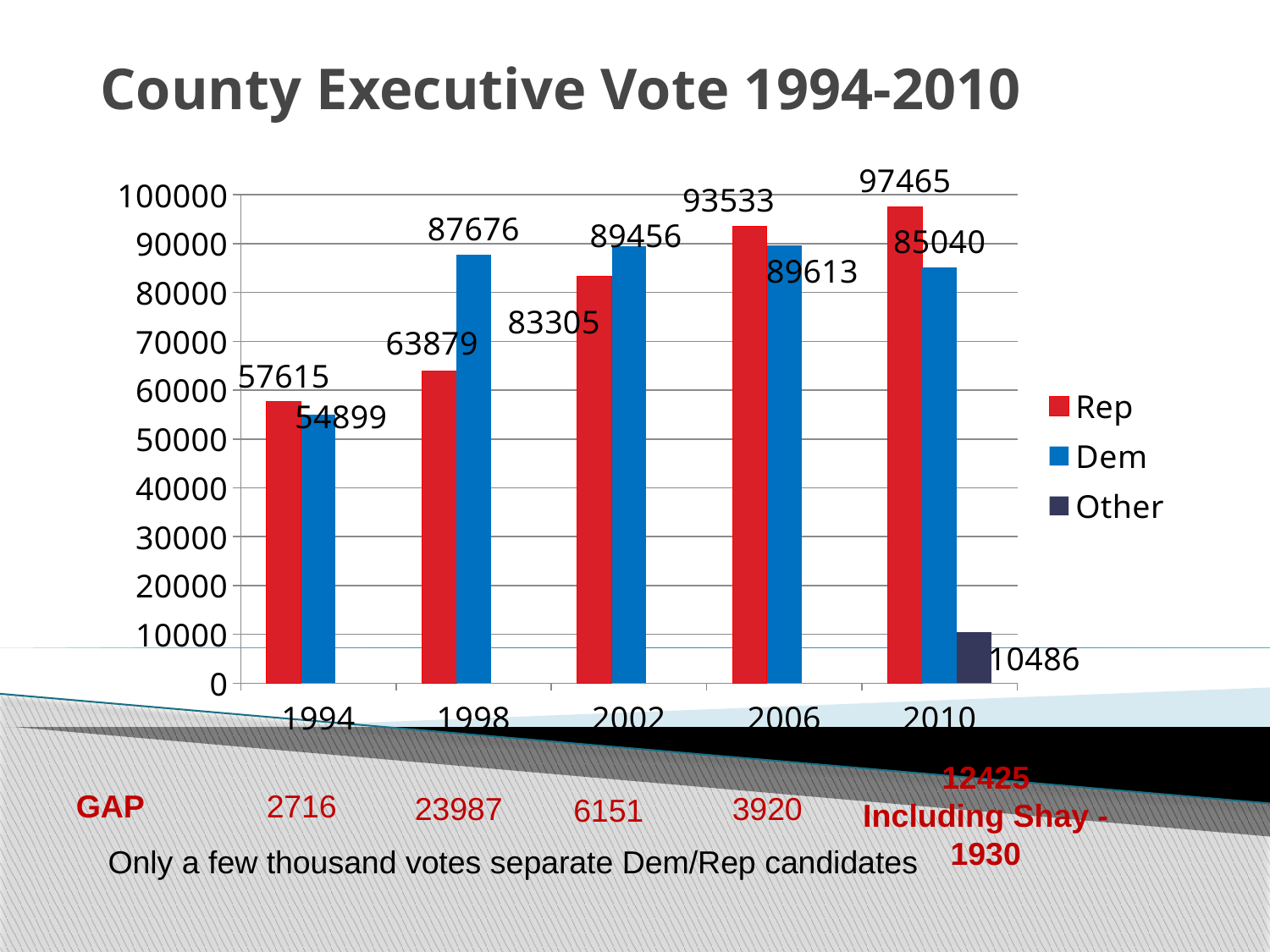
In which year was the Dem vote lowest? 1994 Does the Rep vote rise or fall from 1994 to 2010? rise How many series does the legend list? 3 What was the Other vote in 2010? 10486 In which year was the Rep vote highest? 2010 How many years are shown on the x axis? 5 What was the Rep vote in 2010? 97465 What is the difference between the Rep and Dem votes in 2006? 3920 What is the difference between the Rep and Dem votes in 2002? 6151 What was the Dem vote in 1998? 87676 Which was larger in 1998, the Rep vote or the Dem vote? Dem What type of chart is shown on the slide? bar chart